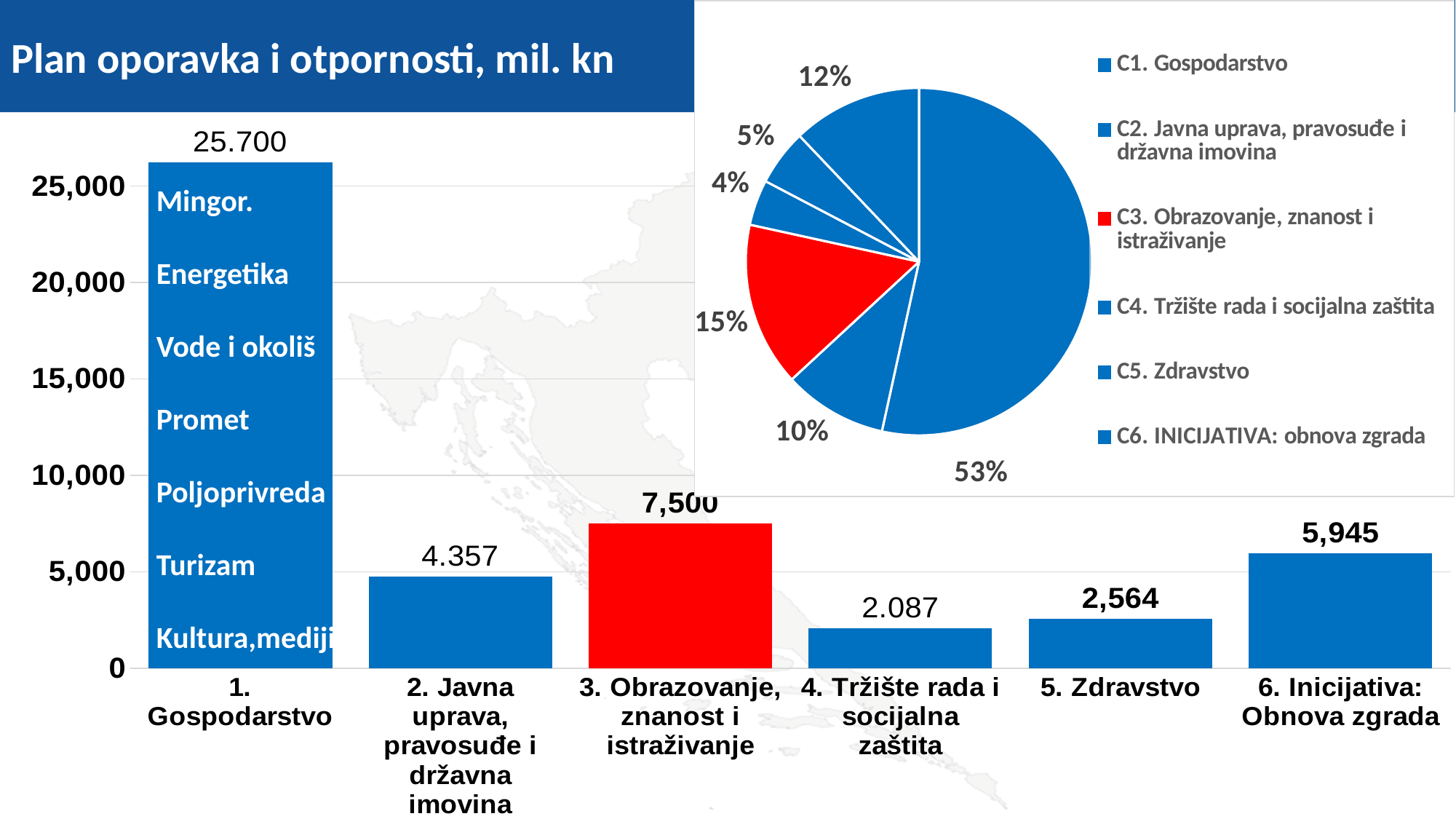
In the bar chart, what is the value for 1. Gospodarstvo? 25.700 In the bar chart, how many categories are shown on the x axis? 6 In the bar chart, what is the difference between 6. Inicijativa: Obnova zgrada and 5. Zdravstvo? 3,381 What type of chart is the chart on the left side of the slide? Bar chart How many entries does the legend of the pie chart list? 6 In the pie chart, what share does the red slice (C3. Obrazovanje, znanost i istraživanje) have? 15% In the bar chart, which is larger: 2. Javna uprava, pravosuđe i državna imovina or 6. Inicijativa: Obnova zgrada? 6. Inicijativa: Obnova zgrada In the bar chart, which category has the highest value? 1. Gospodarstvo In the bar chart, which category has the lowest value? 4. Tržište rada i socijalna zaštita In the bar chart, what is the value for 3. Obrazovanje, znanost i istraživanje? 7,500 In the bar chart, what is the value for 5. Zdravstvo? 2,564 In the pie chart, what share does the largest slice have? 53%